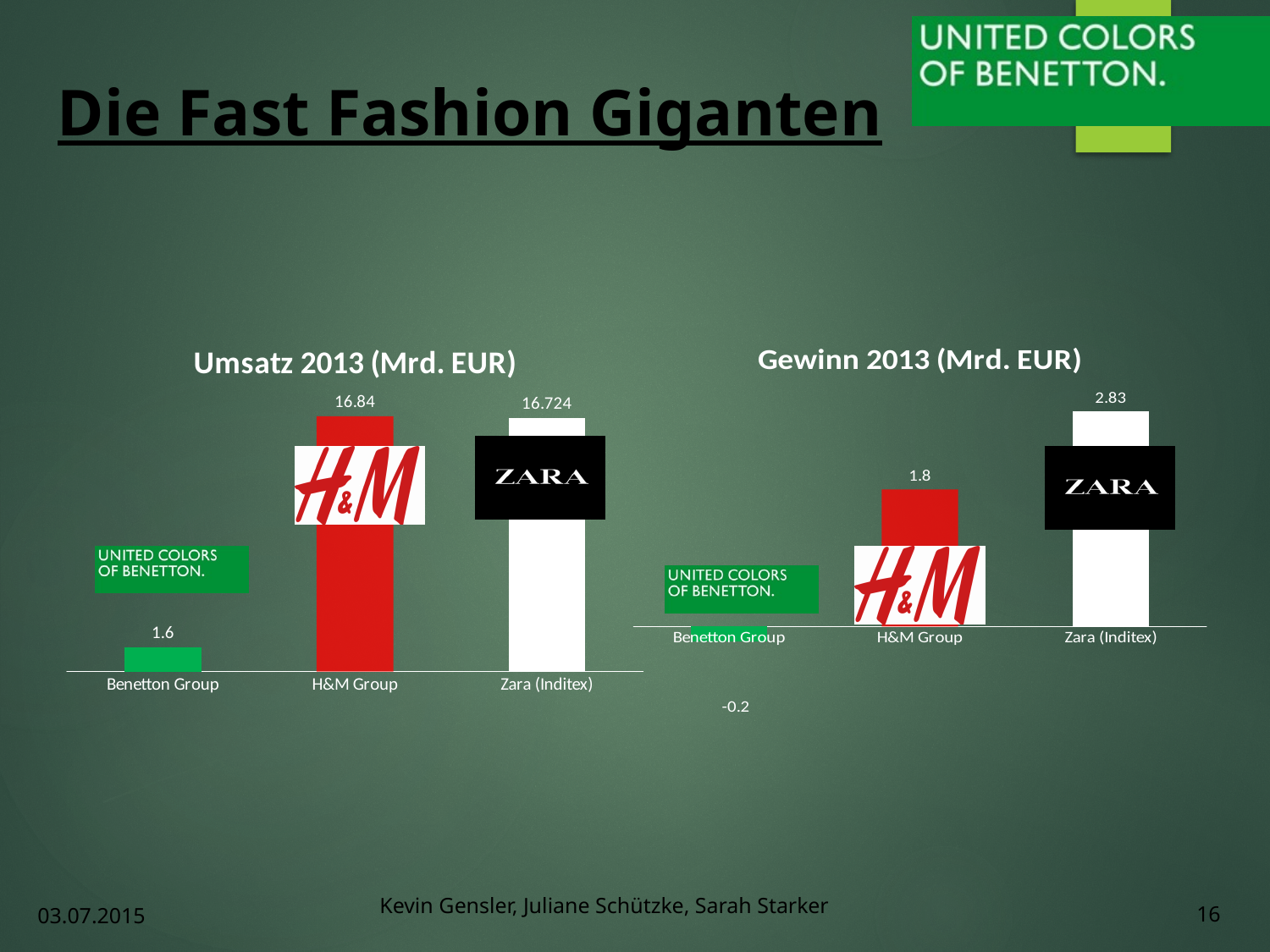
In the Gewinn 2013 (Mrd. EUR) chart, which category has the highest value? Zara (Inditex) In the Umsatz 2013 (Mrd. EUR) chart, what is the value for H&M Group? 16.84 What kind of chart is the Umsatz 2013 (Mrd. EUR) chart? Bar chart In the Gewinn 2013 (Mrd. EUR) chart, what is the value for Zara (Inditex)? 2.83 In the Umsatz 2013 (Mrd. EUR) chart, what is the value for Zara (Inditex)? 16.724 In the Umsatz 2013 (Mrd. EUR) chart, which is larger, H&M Group or Zara (Inditex)? H&M Group How many categories are shown in the Gewinn 2013 (Mrd. EUR) chart? 3 In the Gewinn 2013 (Mrd. EUR) chart, what is the value for Benetton Group? -0.2 In the Umsatz 2013 (Mrd. EUR) chart, what is the value for Benetton Group? 1.6 In the Umsatz 2013 (Mrd. EUR) chart, which category has the lowest value? Benetton Group In the Gewinn 2013 (Mrd. EUR) chart, which category has the lowest value? Benetton Group In the Gewinn 2013 (Mrd. EUR) chart, what is the difference between Zara (Inditex) and H&M Group? 1.03